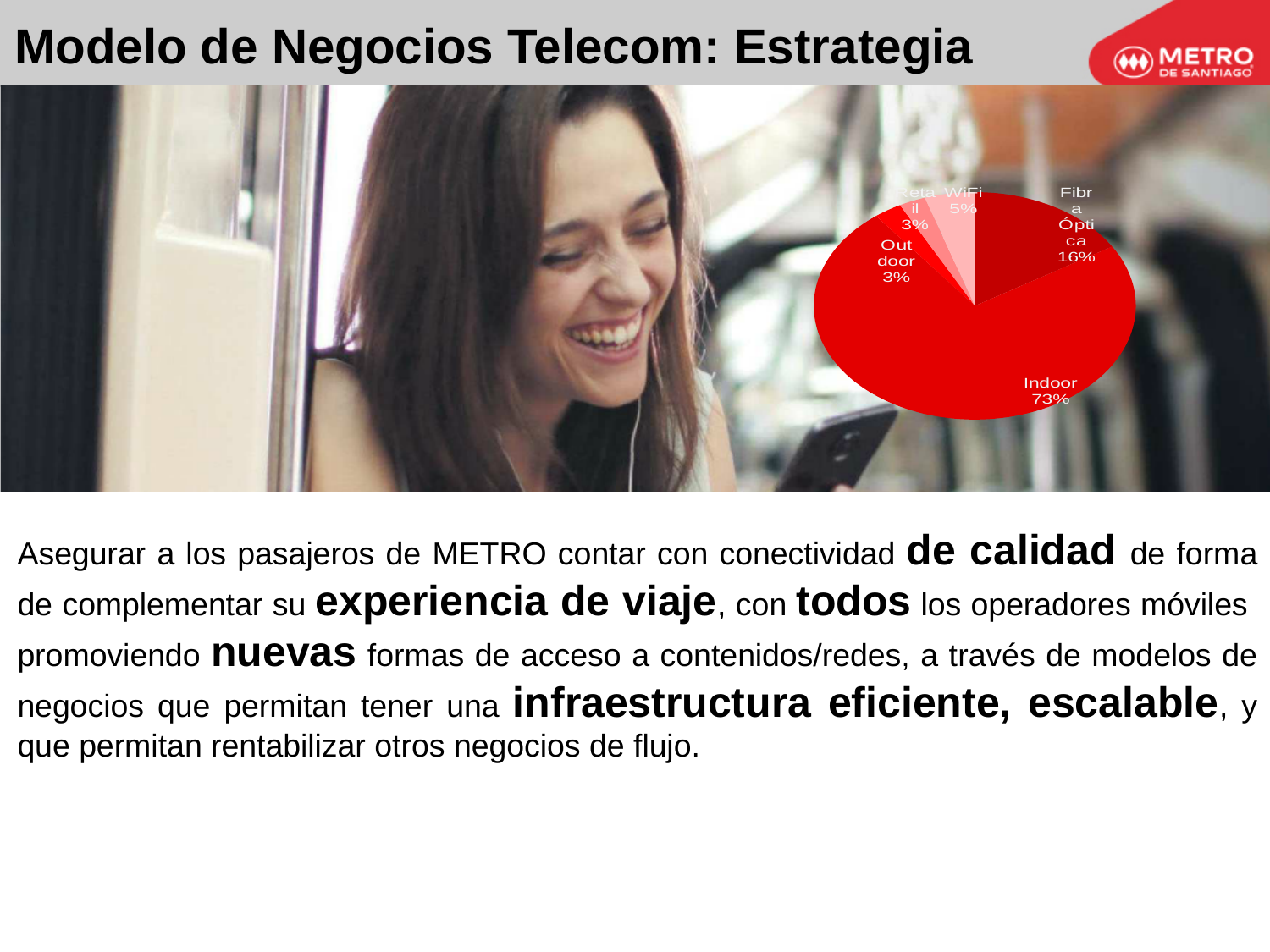
Which is larger, the Fibra Óptica slice or the WiFi slice? Fibra Óptica What is the difference in percentage points between the WiFi slice and the Outdoor slice? 2 What share of the pie does Outdoor represent? 3% What kind of chart is shown on the slide? pie chart Is the Indoor share greater or less than 50%? greater How many slices does the pie chart have? 5 What is the difference in percentage points between the Indoor slice and the Fibra Óptica slice? 57 What colour are the slices of the pie chart? red What share of the pie does Indoor represent? 73% Which slice of the pie chart is the largest? Indoor What share of the pie does Fibra Óptica represent? 16%